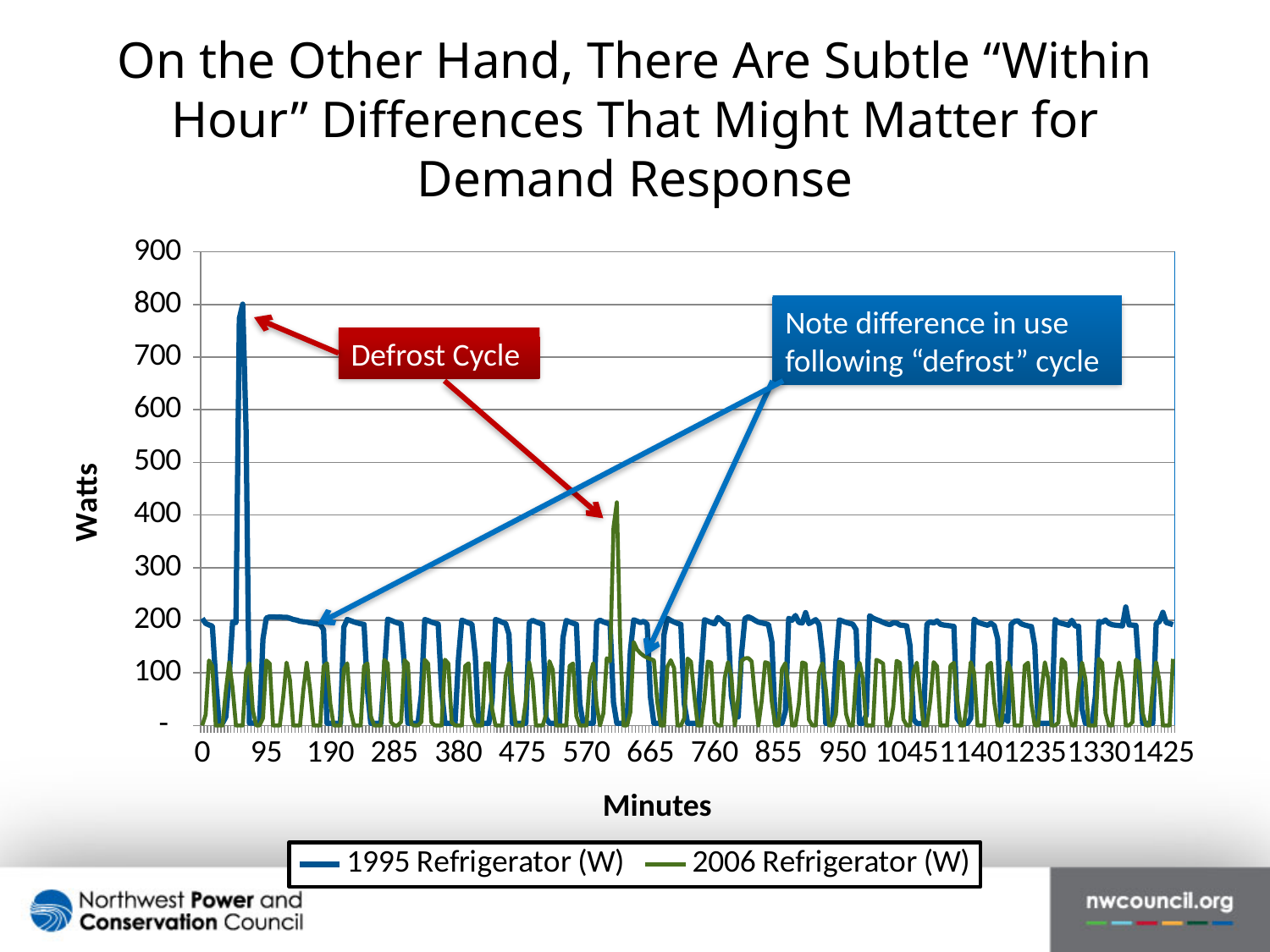
Is the highest peak of the 2006 Refrigerator (W) series greater or less than 300? greater How many series does the chart's legend list? 2 Excluding the defrost spike, is the level of the 1995 Refrigerator (W) series during its regular on-cycles greater or less than 300? less Excluding the defrost spike, is the level of the 2006 Refrigerator (W) series during its regular on-cycles greater or less than 200? less What kind of chart is shown on the slide? line chart What is the label on the chart's vertical axis? Watts How many labeled tick marks are shown on the chart's horizontal (Minutes) axis? 16 Which series reaches the higher peak value, 1995 Refrigerator (W) or 2006 Refrigerator (W)? 1995 Refrigerator (W) What are the two series named in the chart's legend? 1995 Refrigerator (W) and 2006 Refrigerator (W)